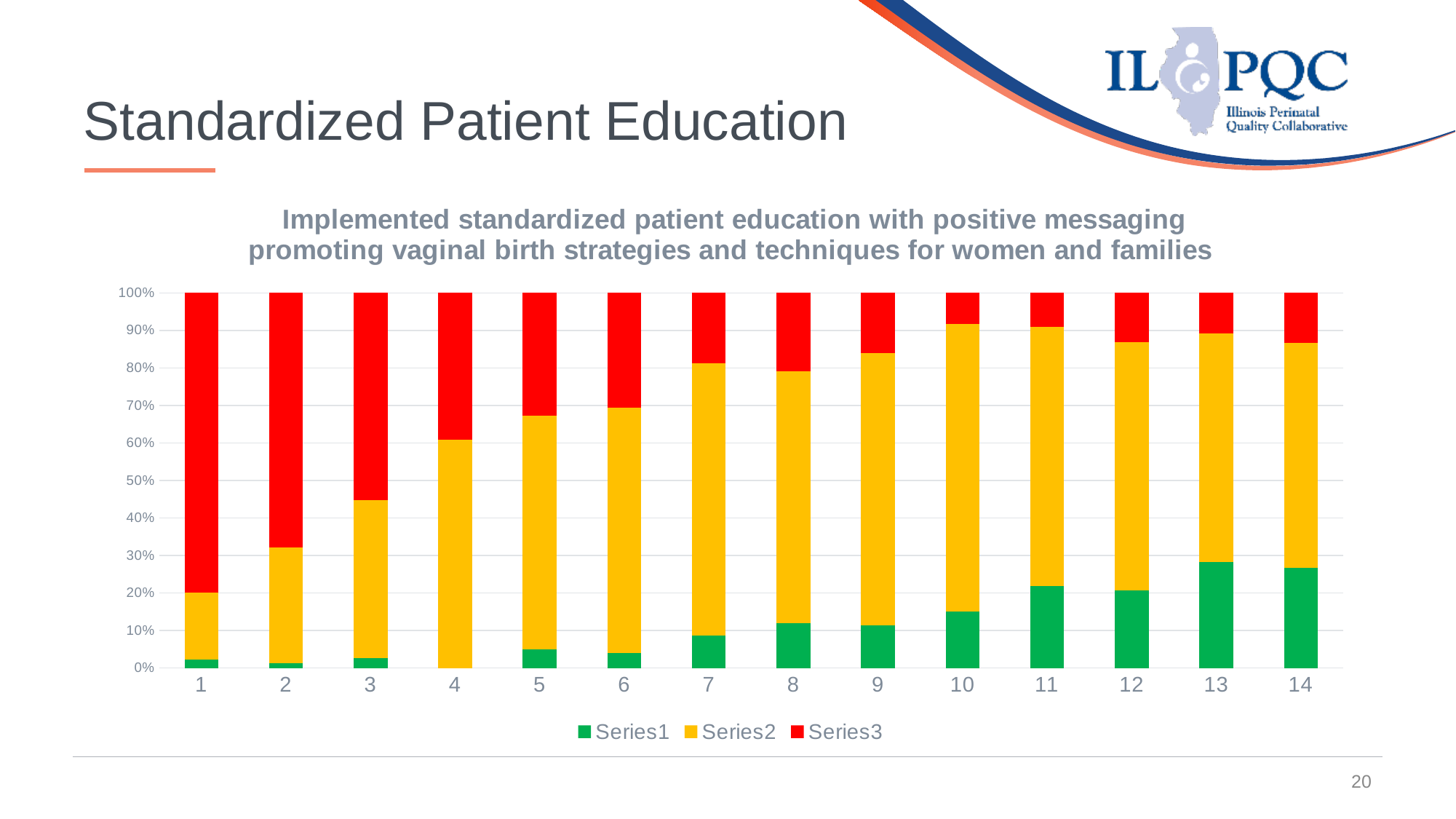
What kind of chart is shown on the slide? stacked bar chart Is the value for Series3 at category 1 greater or less than 70%? greater Is the value for Series1 at category 13 greater or less than 20%? greater Is the value for Series3 at category 10 greater or less than 10%? less Which colour represents Series3 in the chart? red How many categories are shown along the x axis of the chart? 14 What are the names of the series listed in the legend? Series1, Series2, Series3 For which category is the Series3 value the highest? 1 Does the Series1 value generally rise or fall from category 1 to category 14? rise How many series does the chart legend list? 3 Is the Series3 value larger at category 1 or at category 14? category 1